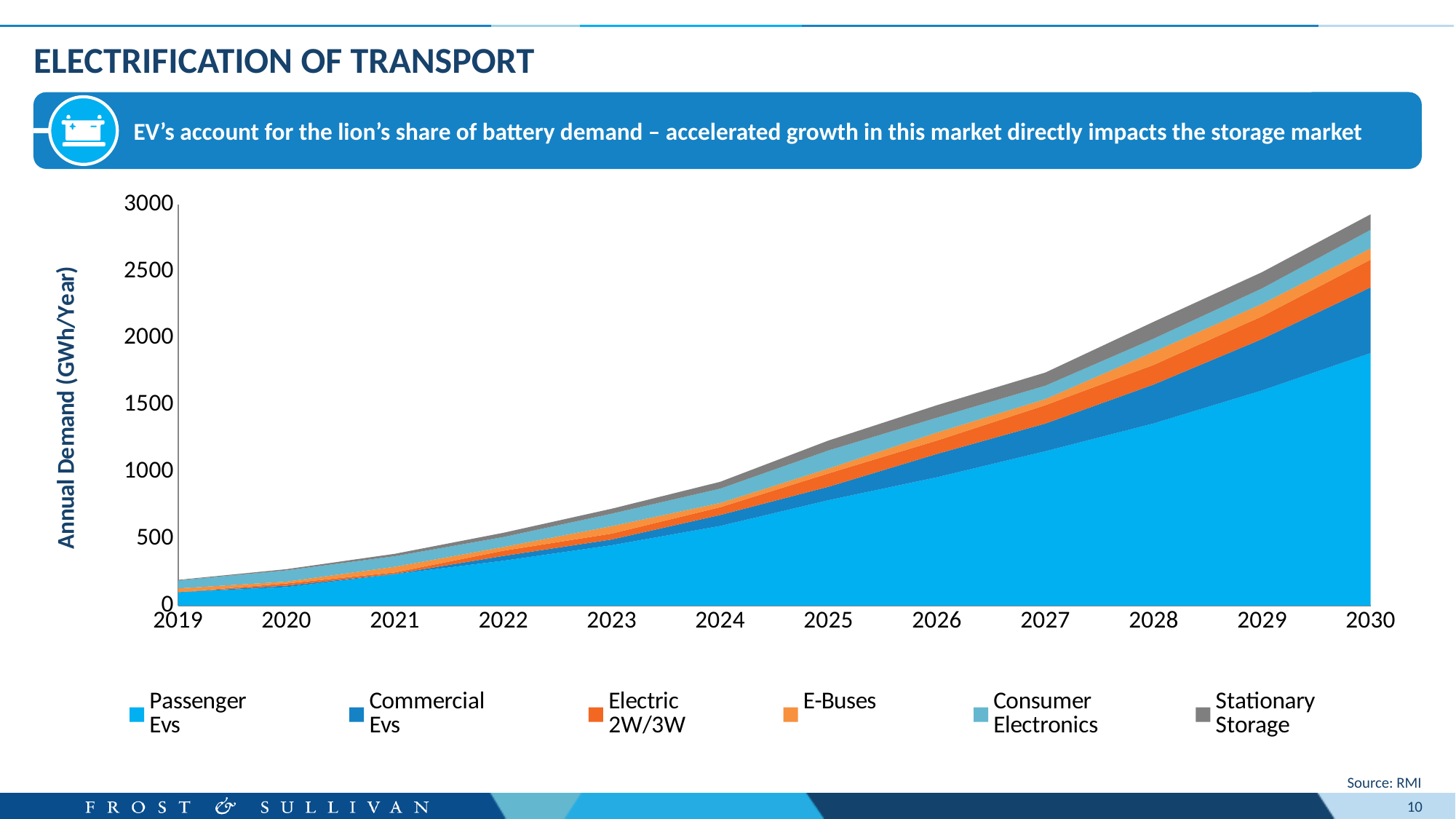
Which year has the highest total annual demand? 2030 What kind of chart is shown on the slide? Stacked area chart Which year has the lowest total annual demand? 2019 Is the total annual demand in 2027 greater or less than 1500? greater Is the total annual demand in 2019 greater or less than 500? less Does total annual demand rise or fall from 2019 to 2030? Rise Is the total annual demand in 2030 greater or less than 2500? greater How many years are shown along the x axis? 12 What is the label on the y axis of the chart? Annual Demand (GWh/Year) Which series accounts for the largest share of annual demand in 2030? Passenger Evs How many series does the legend list? 6